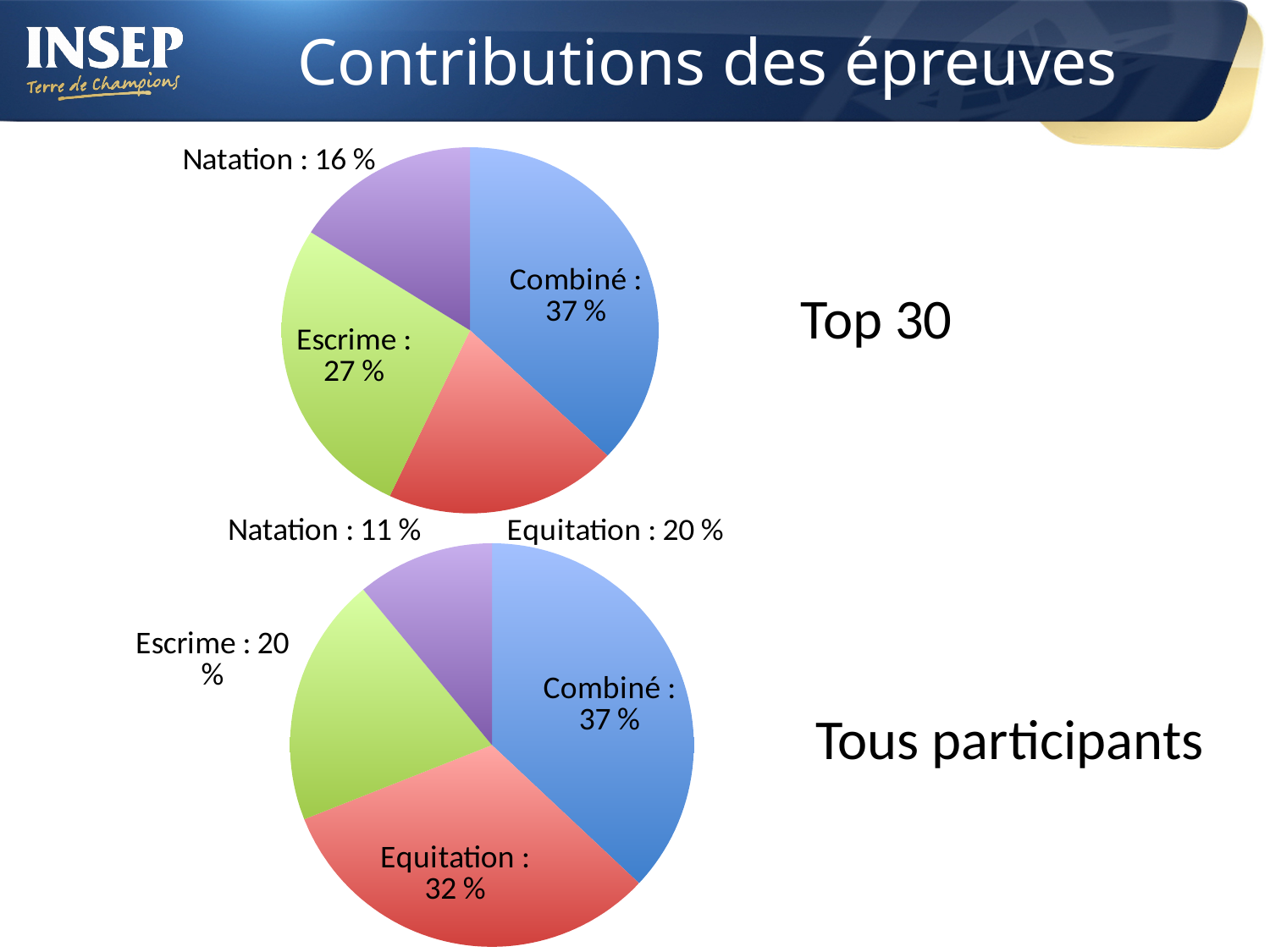
What type of chart is used for the Top 30 data? Pie chart In the Top 30 pie chart, what share does Natation have? 16 % In the Tous participants pie chart, which is larger, the share of Equitation or the share of Escrime? Equitation What is the title of the slide containing the two pie charts? Contributions des épreuves How many categories are shown in the Tous participants pie chart? 4 In the Tous participants pie chart, which category has the smallest share? Natation In the Tous participants pie chart, what share does Equitation have? 32 % In the Top 30 pie chart, what share does Escrime have? 27 % In the Top 30 pie chart, what share does Combiné have? 37 % In the Top 30 pie chart, which category has the largest share? Combiné In the Tous participants pie chart, what share does Natation have? 11 % In the Top 30 pie chart, what is the difference between the shares of Escrime and Equitation? 7 %